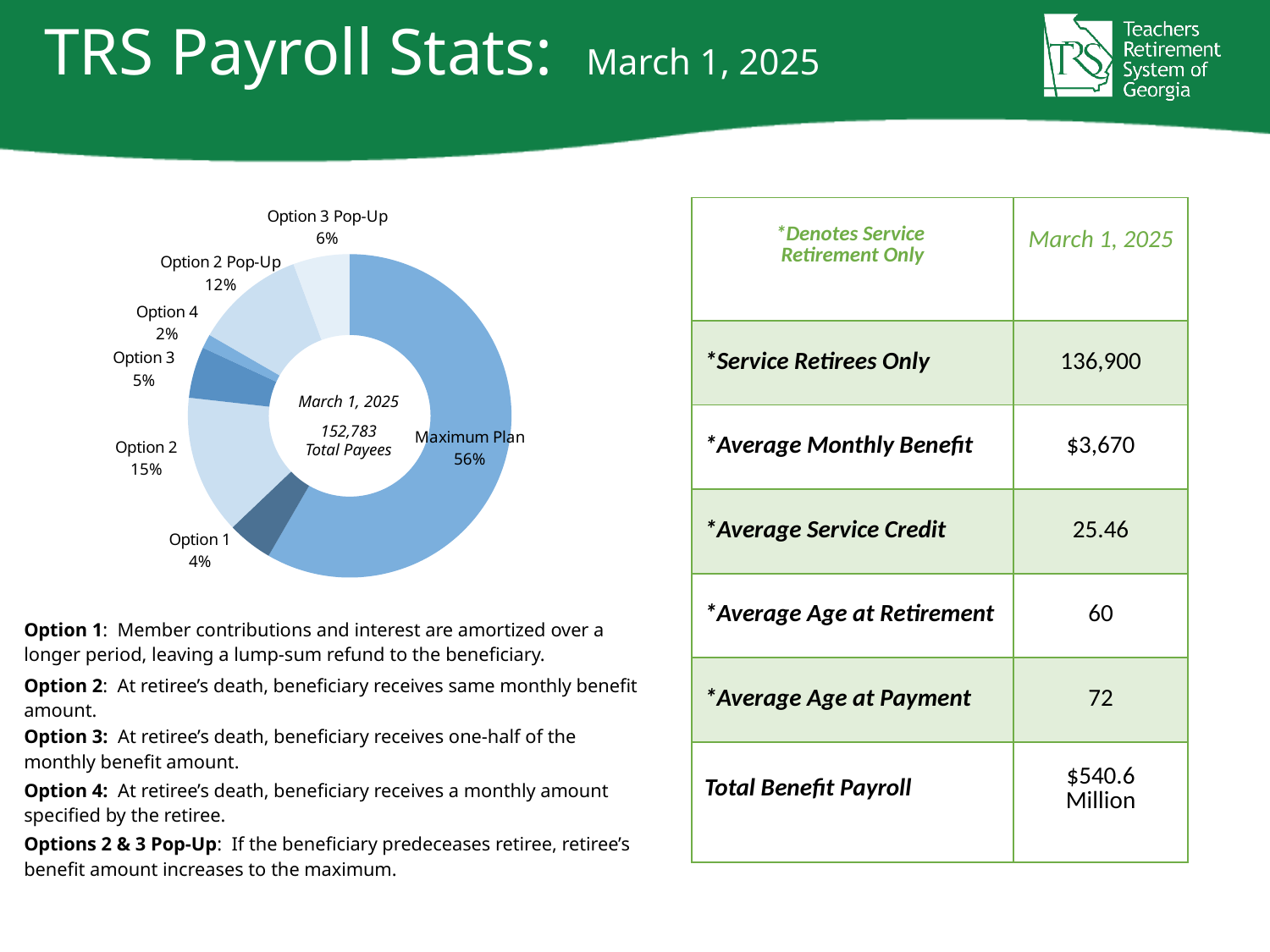
What share of total payees is on the Maximum Plan? 56% What kind of chart is shown on the slide? Pie chart (doughnut) What percentage of payees chose Option 2? 15% What percentage of payees chose Option 4? 2% What is the difference in percentage points between Option 2 and Option 1? 11 Which has a larger share of payees, Option 3 or Option 3 Pop-Up? Option 3 Pop-Up What date is shown in the center of the chart? March 1, 2025 Which plan option has the largest share of payees? Maximum Plan What is the total number of payees shown in the center of the chart? 152,783 Which plan option has the smallest share of payees? Option 4 How many plan options are shown in the chart? 7 What percentage of payees chose Option 2 Pop-Up? 12%